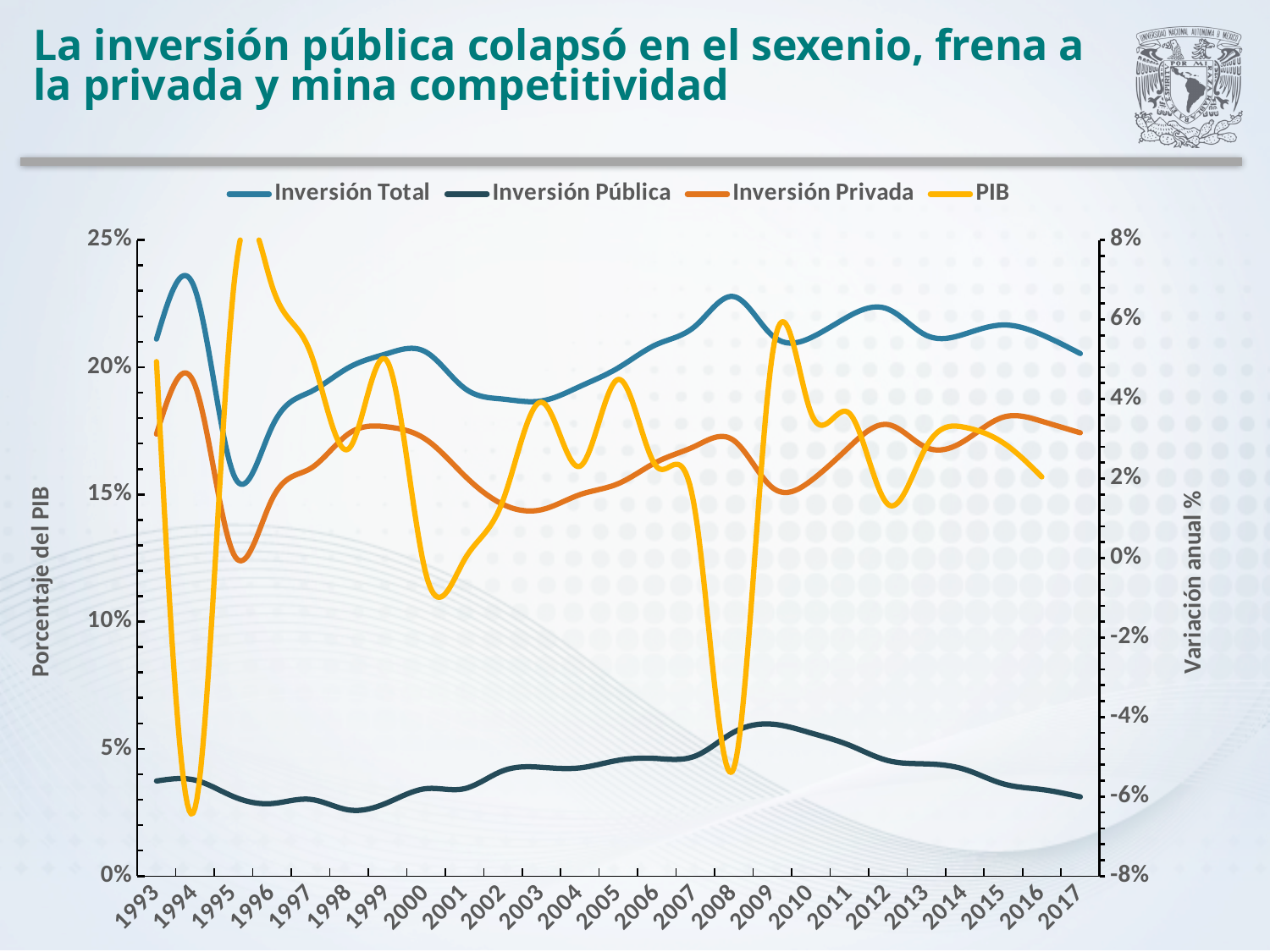
Is the value for Inversión Pública in 2009 greater or less than 5%? greater How many series does the legend list? 4 Which series is plotted highest across the whole chart? Inversión Total How many years are shown on the x axis? 25 Is the value for PIB in 2009 greater or less than -4%? greater Is the value for Inversión Total in 1994 greater or less than 20%? greater What is the title of the left vertical axis? Porcentaje del PIB Does Inversión Pública rise or fall from 2009 to 2017? Fall In 2010, which is larger: Inversión Total or Inversión Pública? Inversión Total What is the title of the right vertical axis? Variación anual % What kind of chart is shown on the slide? Line chart